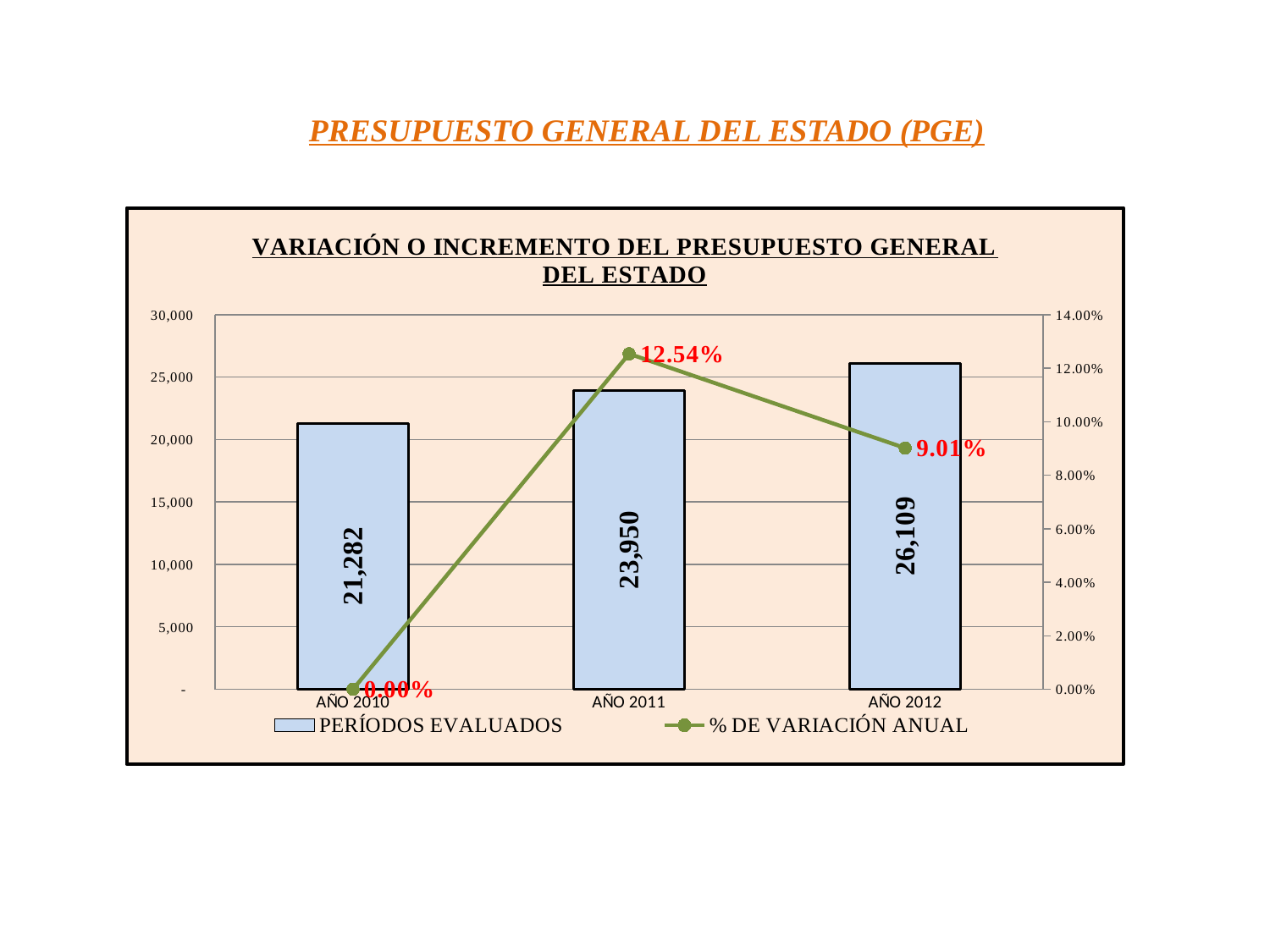
Which is larger, the % DE VARIACIÓN ANUAL for AÑO 2011 or for AÑO 2012? AÑO 2011 Which year has the highest PERÍODOS EVALUADOS value? AÑO 2012 How many series does the legend list? 2 Do the PERÍODOS EVALUADOS bar values rise or fall from AÑO 2010 to AÑO 2012? rise How many years are shown on the x axis? 3 What is the value of PERÍODOS EVALUADOS for AÑO 2012? 26,109 What is the difference between the PERÍODOS EVALUADOS values for AÑO 2012 and AÑO 2011? 2,159 Which year has the lowest % DE VARIACIÓN ANUAL? AÑO 2010 What is the value of PERÍODOS EVALUADOS for AÑO 2010? 21,282 What is the % DE VARIACIÓN ANUAL for AÑO 2011? 12.54% What is the % DE VARIACIÓN ANUAL for AÑO 2012? 9.01% What is the title of the chart? VARIACIÓN O INCREMENTO DEL PRESUPUESTO GENERAL DEL ESTADO